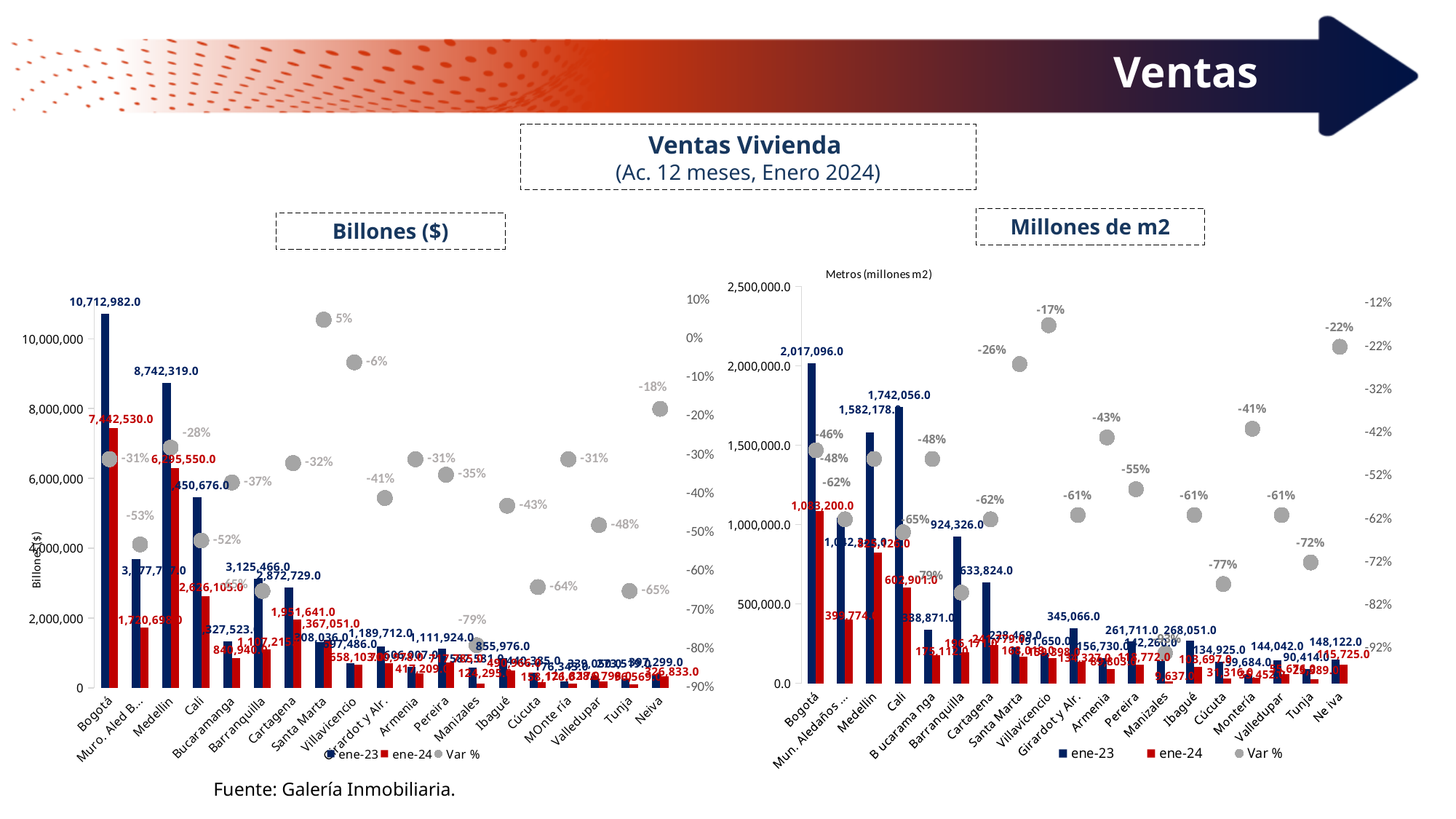
In the 'Millones de m2' chart, what is the Var % for Villavicencio? -17% In the 'Billones ($)' chart, what is the difference between the ene-23 and ene-24 values for Bogotá? 3,270,452.0 How many cities are shown on the x axis of the 'Billones ($)' chart? 19 In the 'Billones ($)' chart, which city has the highest ene-23 value? Bogotá In the 'Millones de m2' chart, is the ene-23 value for Barranquilla greater or less than 1,000,000.0? less In the 'Billones ($)' chart, what is the ene-23 value for Bogotá? 10,712,982.0 In the 'Billones ($)' chart, which city has the lowest Var %? Manizales In the 'Millones de m2' chart, which is larger, the ene-23 value for Medellín or for Cali? Cali How many series does the legend of the 'Millones de m2' chart list? 3 In the 'Billones ($)' chart, what is the Var % for Santa Marta? 5% In the 'Millones de m2' chart, what is the ene-23 value for Cali? 1,742,056.0 In the 'Billones ($)' chart, what is the ene-24 value for Bogotá? 7,442,530.0